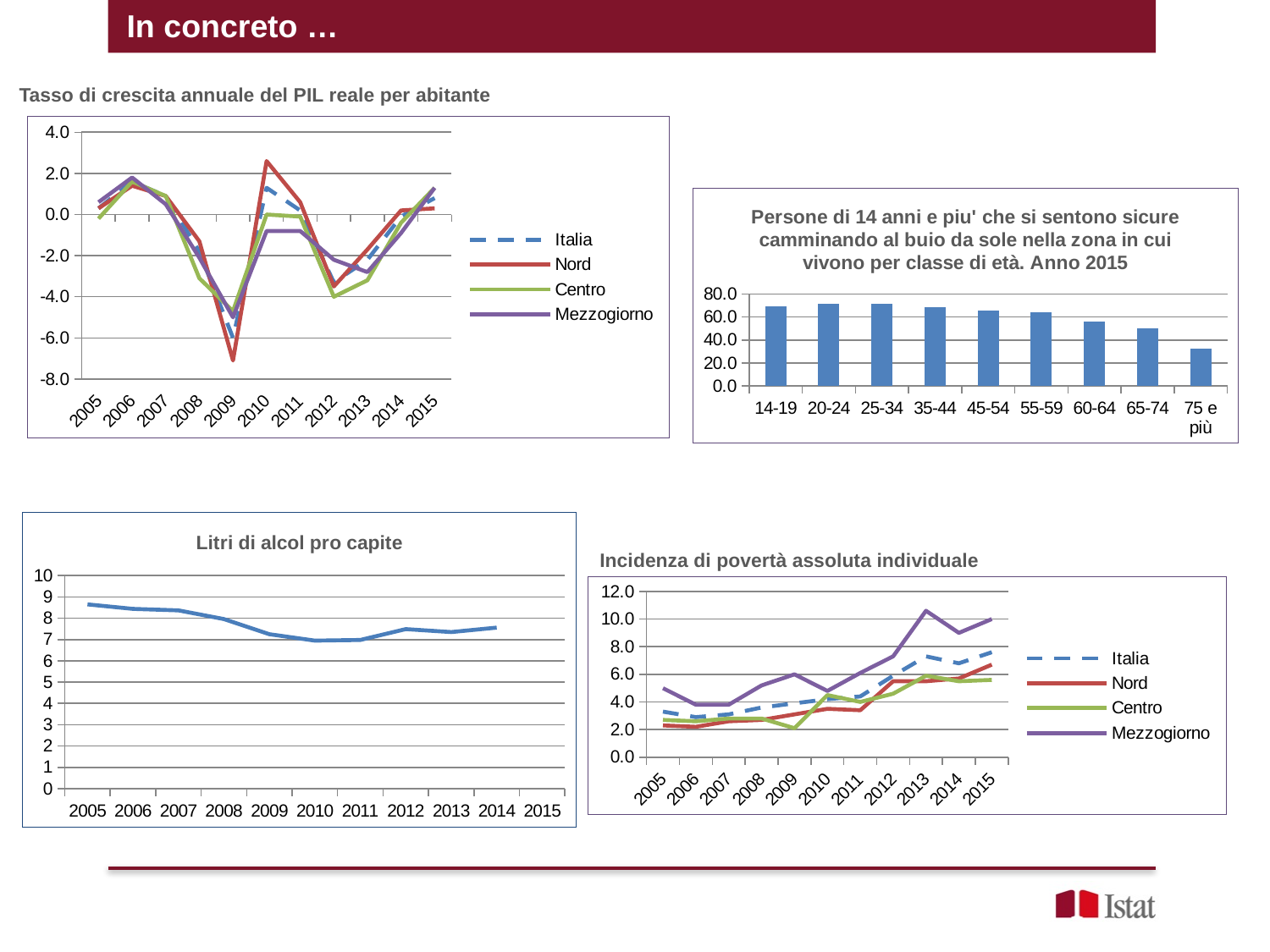
In "Litri di alcol pro capite", is the value for 2005 greater or less than 8? greater In "Incidenza di povertà assoluta individuale", which series has the highest value in 2013? Mezzogiorno In "Litri di alcol pro capite", do the values overall rise or fall from 2005 to 2014? fall In "Tasso di crescita annuale del PIL reale per abitante", in which year do all series reach their lowest value? 2009 In the chart "Persone di 14 anni e piu' che si sentono sicure camminando al buio da sole...", which age class has the lowest value? 75 e più What kind of chart is "Tasso di crescita annuale del PIL reale per abitante"? line chart How many series does the legend of "Tasso di crescita annuale del PIL reale per abitante" list? 4 In "Incidenza di povertà assoluta individuale", is the value for Mezzogiorno in 2013 greater or less than 10.0? greater In the chart "Persone di 14 anni e piu' che si sentono sicure camminando al buio da sole...", is the value for 75 e più greater or less than 40.0? less How many age classes are shown in the chart "Persone di 14 anni e piu' che si sentono sicure camminando al buio da sole..."? 9 What kind of chart is "Persone di 14 anni e piu' che si sentono sicure camminando al buio da sole nella zona in cui vivono per classe di età. Anno 2015"? bar chart